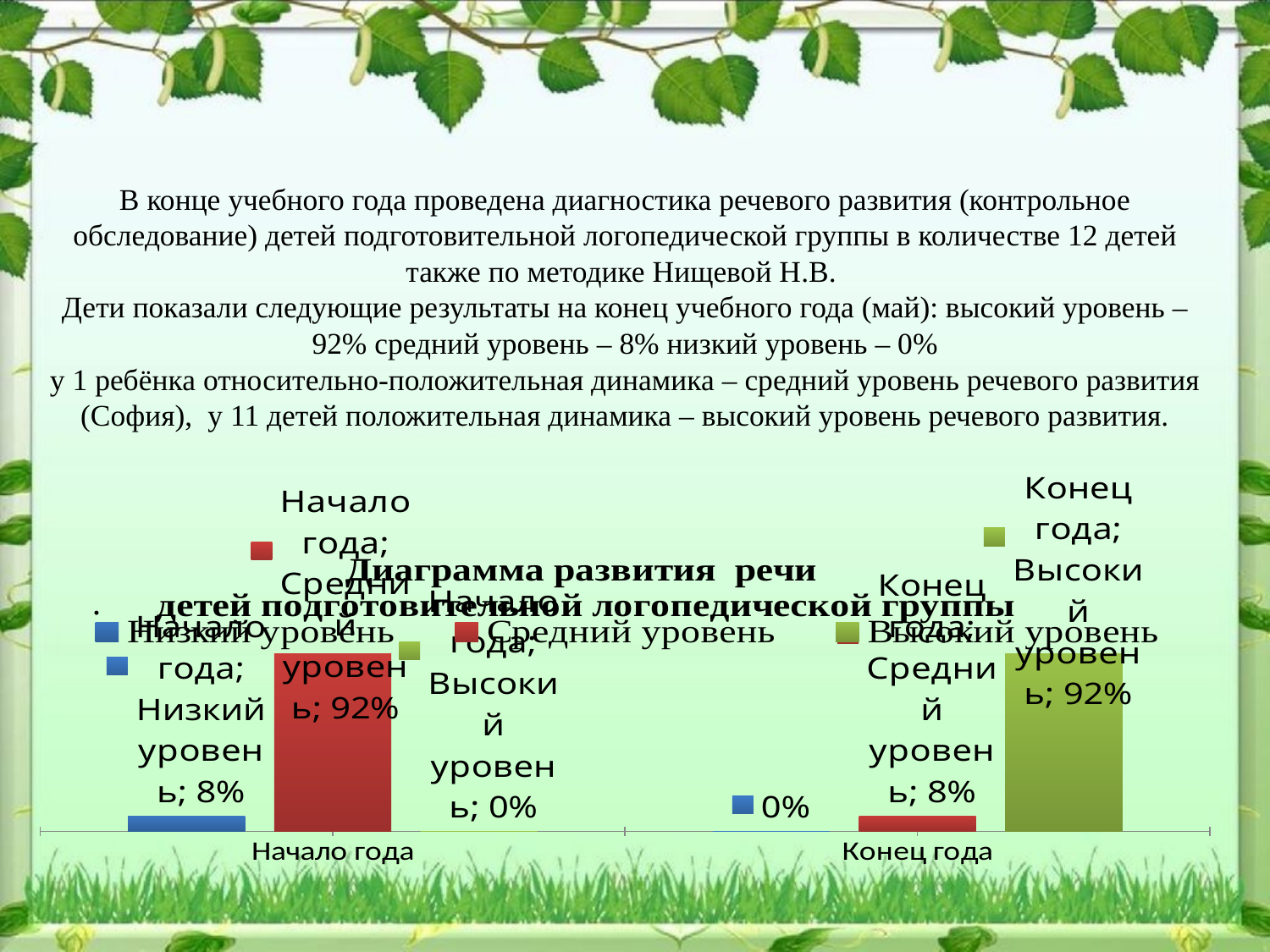
Which series has the highest value at Конец года? Высокий уровень What is the value for Средний уровень at Конец года? 8% Which series has the lowest value at Начало года? Высокий уровень What is the value for Высокий уровень at Начало года? 0% How many series does the chart legend list? 3 What kind of chart is shown on the slide? bar chart What is the value for Низкий уровень at Начало года? 8% Which colour represents Высокий уровень in the chart legend? green What is the value for Средний уровень at Начало года? 92% What is the difference between Средний уровень at Начало года and Средний уровень at Конец года? 84% How many categories are shown on the x axis of the chart? 2 What is the value for Высокий уровень at Конец года? 92%